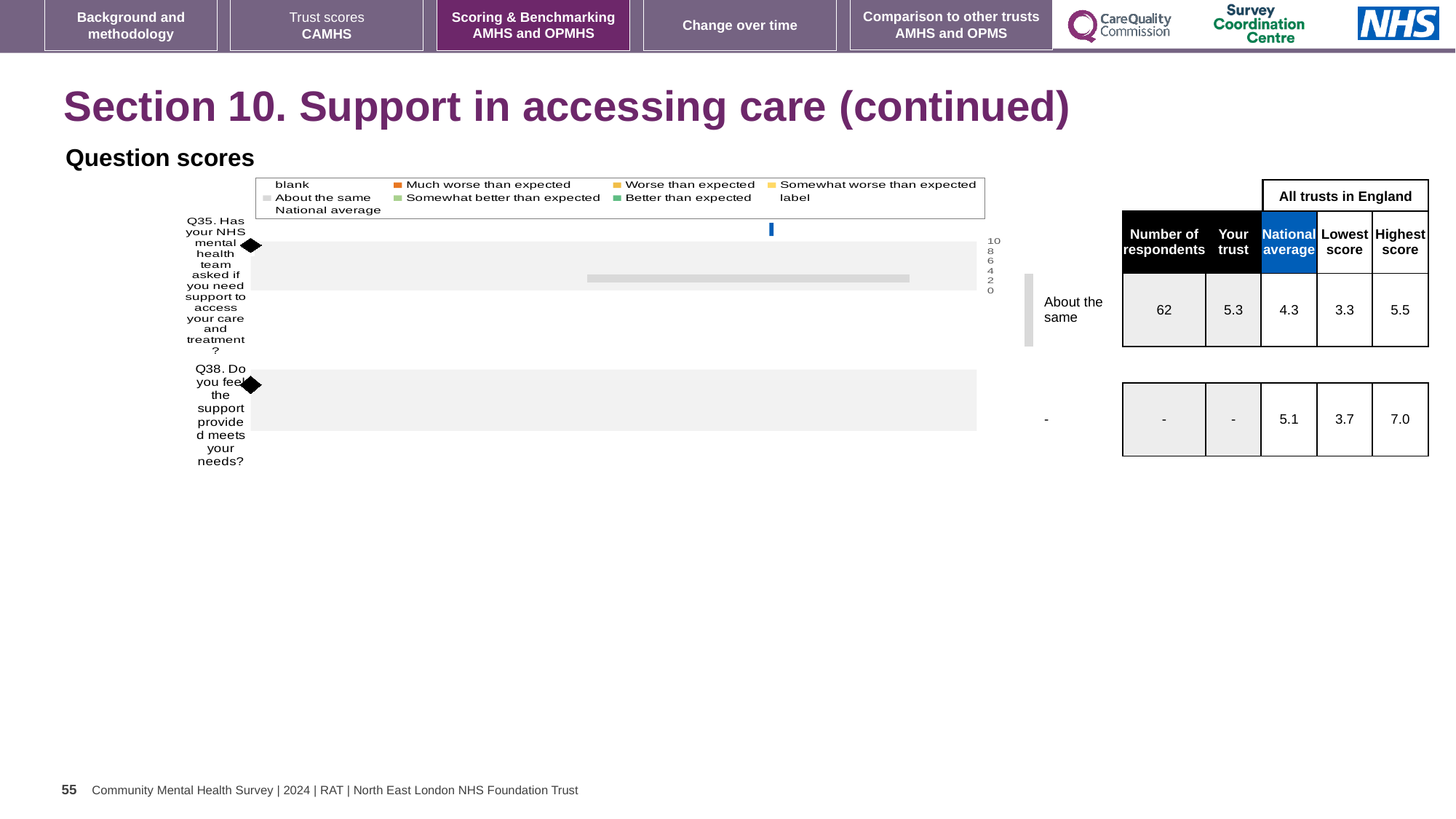
What is the difference between the highest score and the lowest score for Q35? 2.2 How many questions (categories) are plotted on the chart? 2 What is the lowest score among all trusts in England for Q38? 3.7 What is the highest score among all trusts in England for Q38? 7.0 According to the table, how many respondents answered Q35? 62 For Q35, which is larger: the "Your trust" score or the national average? Your trust What kind of chart is shown under "Question scores"? bar chart What is the difference between the highest score and the lowest score for Q38? 3.3 What is the national average score for Q35? 4.3 What benchmark category label is shown next to Q35? About the same What is the highest tick value shown on the chart's score axis? 10 What is the "Your trust" score for Q35? 5.3